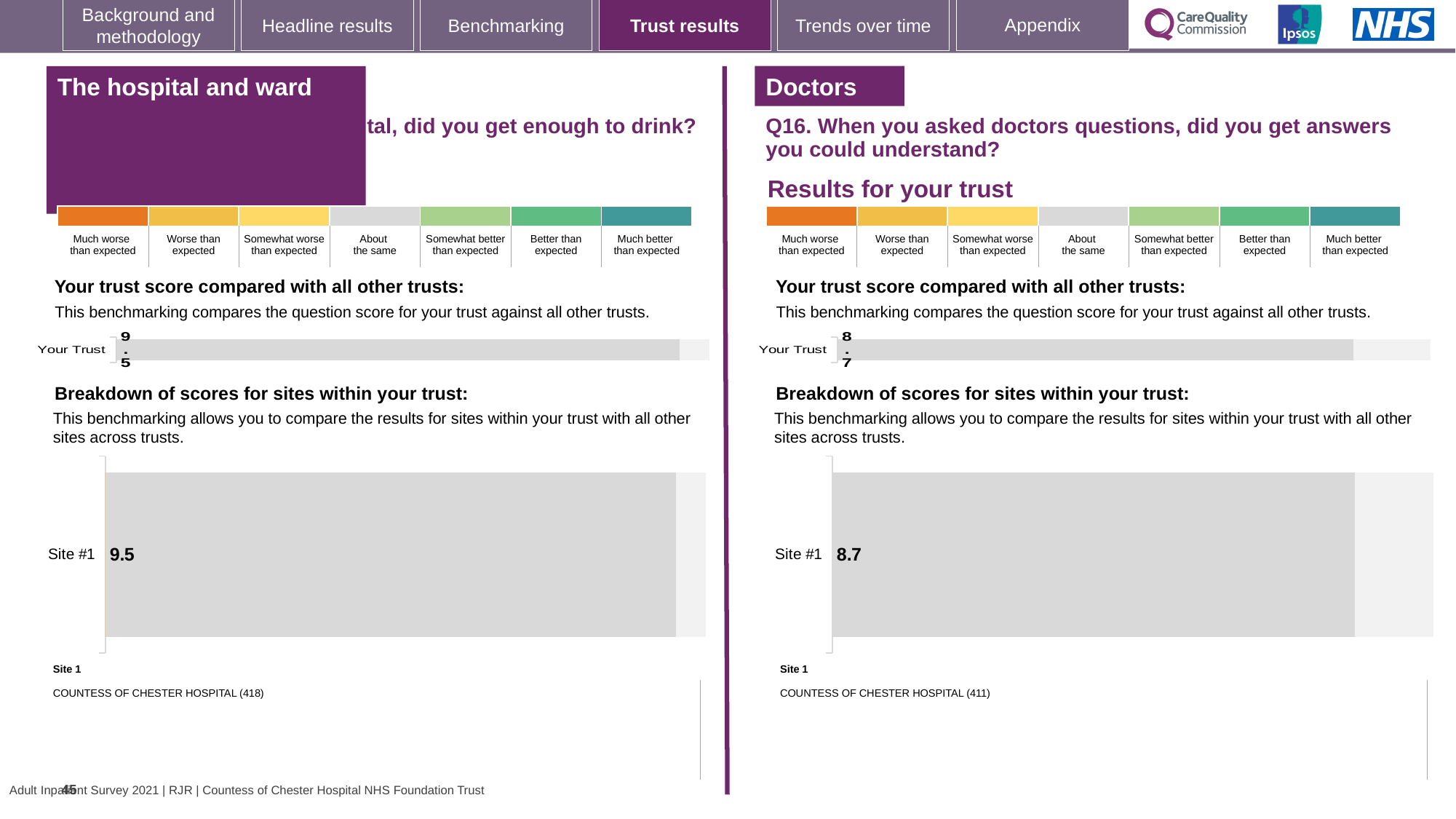
On the right-hand 'Breakdown of scores for sites within your trust' chart under Q16, what is the score for Site #1? 8.7 How many sites are plotted on the left-hand 'Breakdown of scores for sites within your trust' chart? 1 How many sites are plotted on the right-hand 'Breakdown of scores for sites within your trust' chart? 1 On the right-hand Q16 'Your trust score' chart, is the Your Trust score greater or less than 9? less What is the difference between the Your Trust score on the left-hand chart and the Your Trust score on the right-hand Q16 chart? 0.8 According to the text below the right-hand breakdown chart, which hospital is Site 1? COUNTESS OF CHESTER HOSPITAL (411) On the left-hand 'Your trust score compared with all other trusts' chart, what is the score shown for Your Trust? 9.5 Comparing the Your Trust scores, which is larger: the score on the left-hand chart or the score on the right-hand Q16 chart? the left-hand chart On the left-hand 'Breakdown of scores for sites within your trust' chart, what is the score for Site #1? 9.5 What type of chart is used for the 'Your trust score compared with all other trusts' charts on this slide? bar chart What is the category label of the single bar on the left-hand 'Breakdown of scores for sites within your trust' chart? Site #1 On the right-hand 'Your trust score compared with all other trusts' chart under Q16, what is the score shown for Your Trust? 8.7